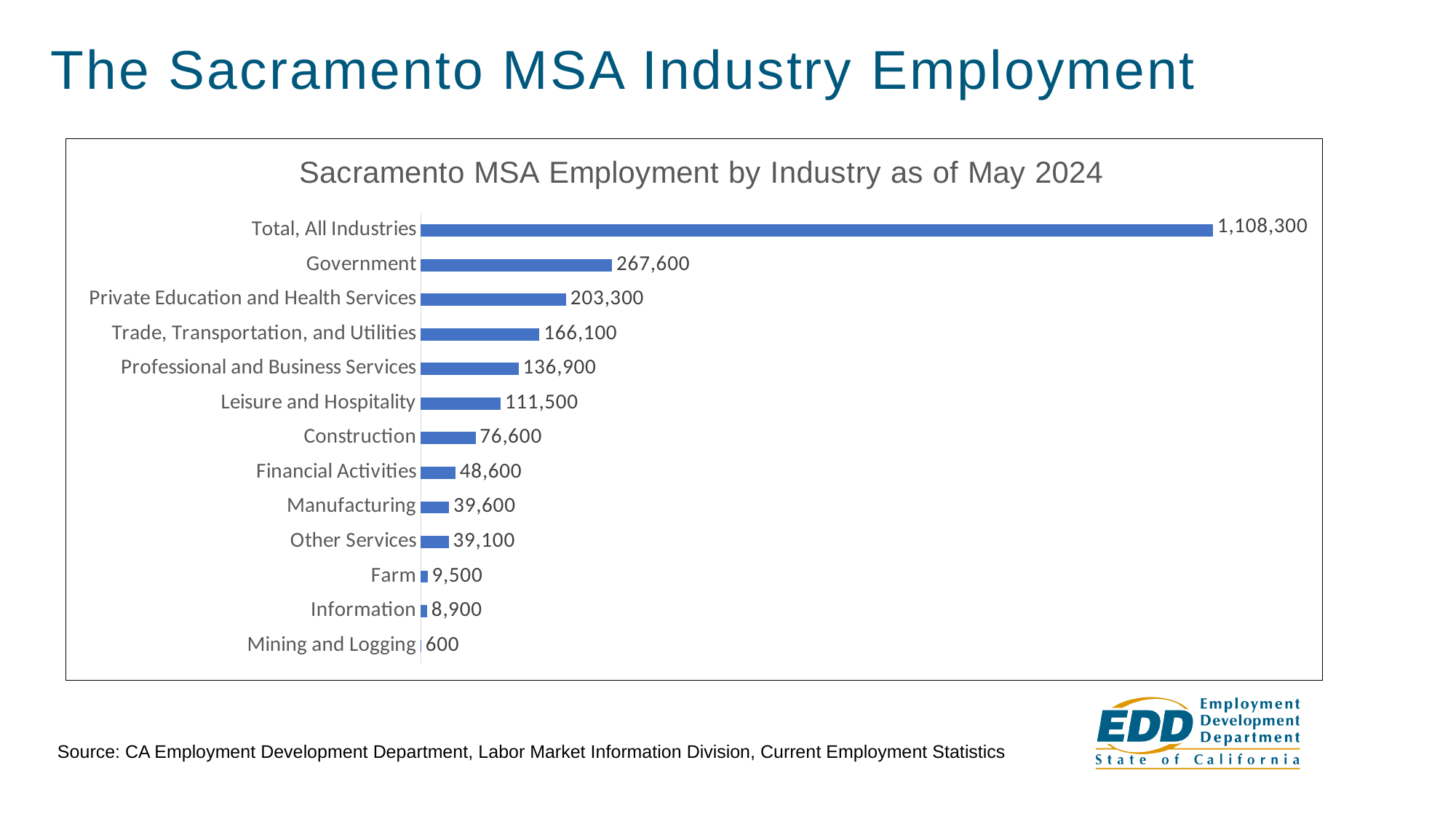
What is the difference in employment between Manufacturing and Other Services? 500 What type of chart is shown on the slide? Bar chart What is the employment value for Mining and Logging? 600 What is the employment value for Government? 267,600 What is the employment value for Construction? 76,600 Excluding the Total, All Industries bar, which industry has the highest employment? Government What is the employment value for Leisure and Hospitality? 111,500 How many categories (bars) are shown in the chart? 13 Which has higher employment, Financial Activities or Construction? Construction What is the title of the chart? Sacramento MSA Employment by Industry as of May 2024 Which category has the lowest employment? Mining and Logging What is the difference in employment between Government and Private Education and Health Services? 64,300